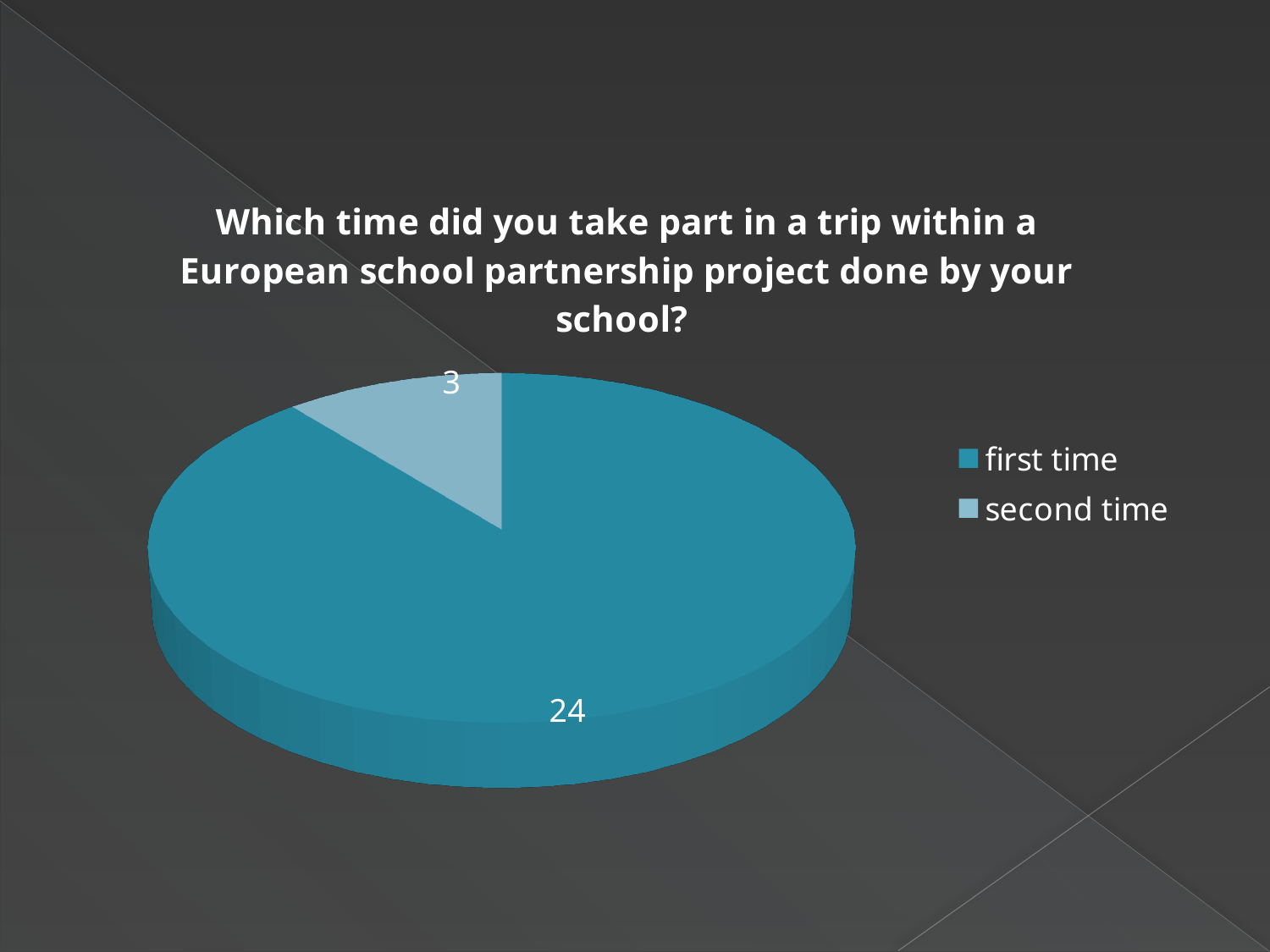
Which category has the largest slice? first time What is the title of the chart? Which time did you take part in a trip within a European school partnership project done by your school? What is the value for "second time"? 3 Which category has the smallest slice? second time What kind of chart is shown on the slide? pie chart What is the difference between the values for "first time" and "second time"? 21 How many slices does the pie chart have? 2 How many entries does the legend list? 2 What is the value for "first time"? 24 Which legend entry is shown in the lighter blue colour? second time What is the total of all slices in the pie chart? 27 Which is larger, the value for "first time" or "second time"? first time